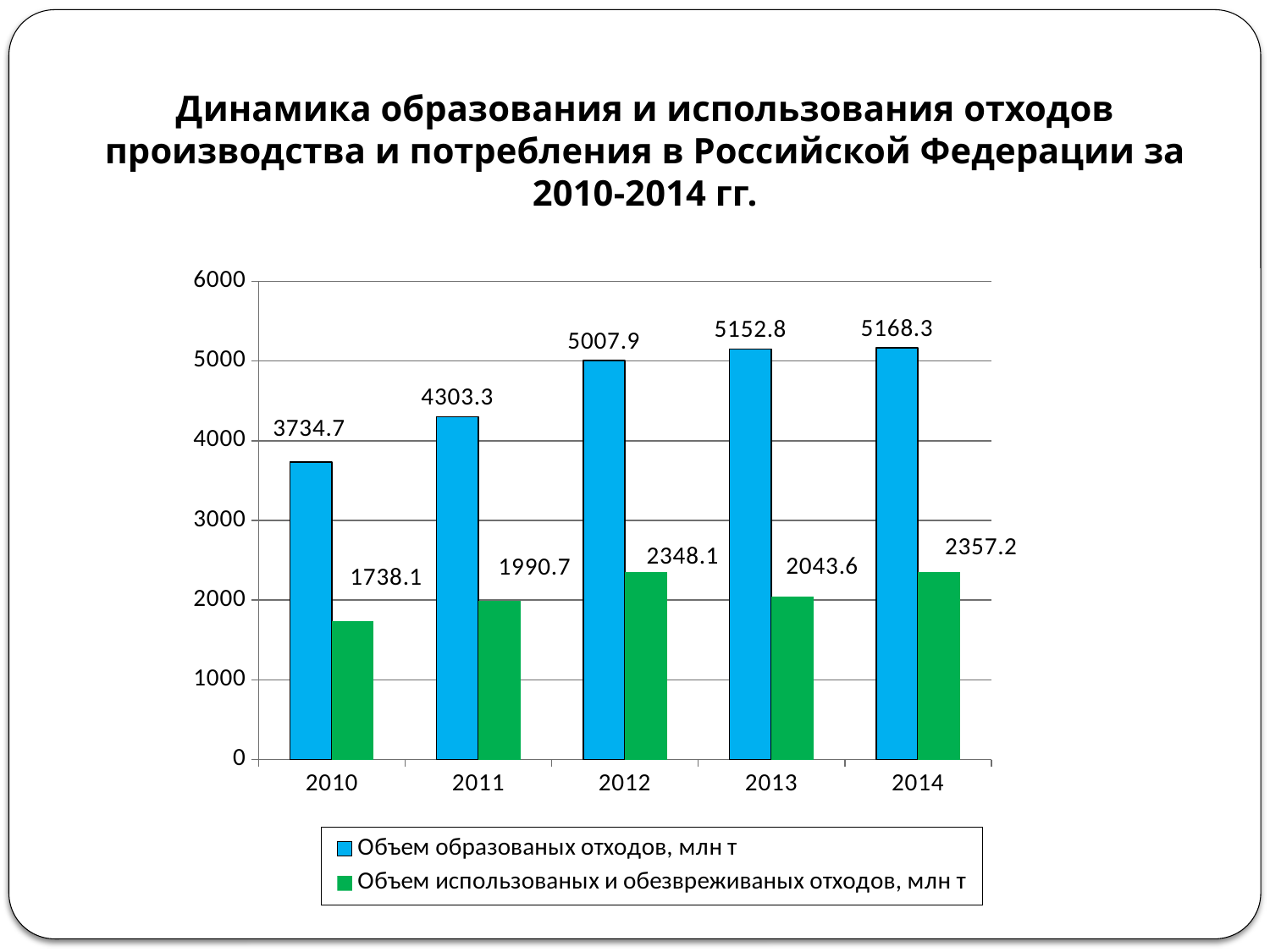
Does 'Объем образованых отходов, млн т' rise or fall from 2010 to 2014? Rise What colour are the bars for 'Объем образованых отходов, млн т'? Blue What type of chart is shown on the slide? Bar chart What is the value of 'Объем использованых и обезвреживаных отходов, млн т' for 2013? 2043.6 Which is larger: 'Объем использованых и обезвреживаных отходов, млн т' in 2012 or in 2013? 2012 In which year is 'Объем образованых отходов, млн т' the highest? 2014 What is the value of 'Объем образованых отходов, млн т' for 2012? 5007.9 How many series does the legend list? 2 In which year is 'Объем использованых и обезвреживаных отходов, млн т' the lowest? 2010 What is the difference between 'Объем образованых отходов, млн т' and 'Объем использованых и обезвреживаных отходов, млн т' in 2014? 2811.1 What is the value of 'Объем образованых отходов, млн т' for 2010? 3734.7 How many years are shown on the x axis? 5